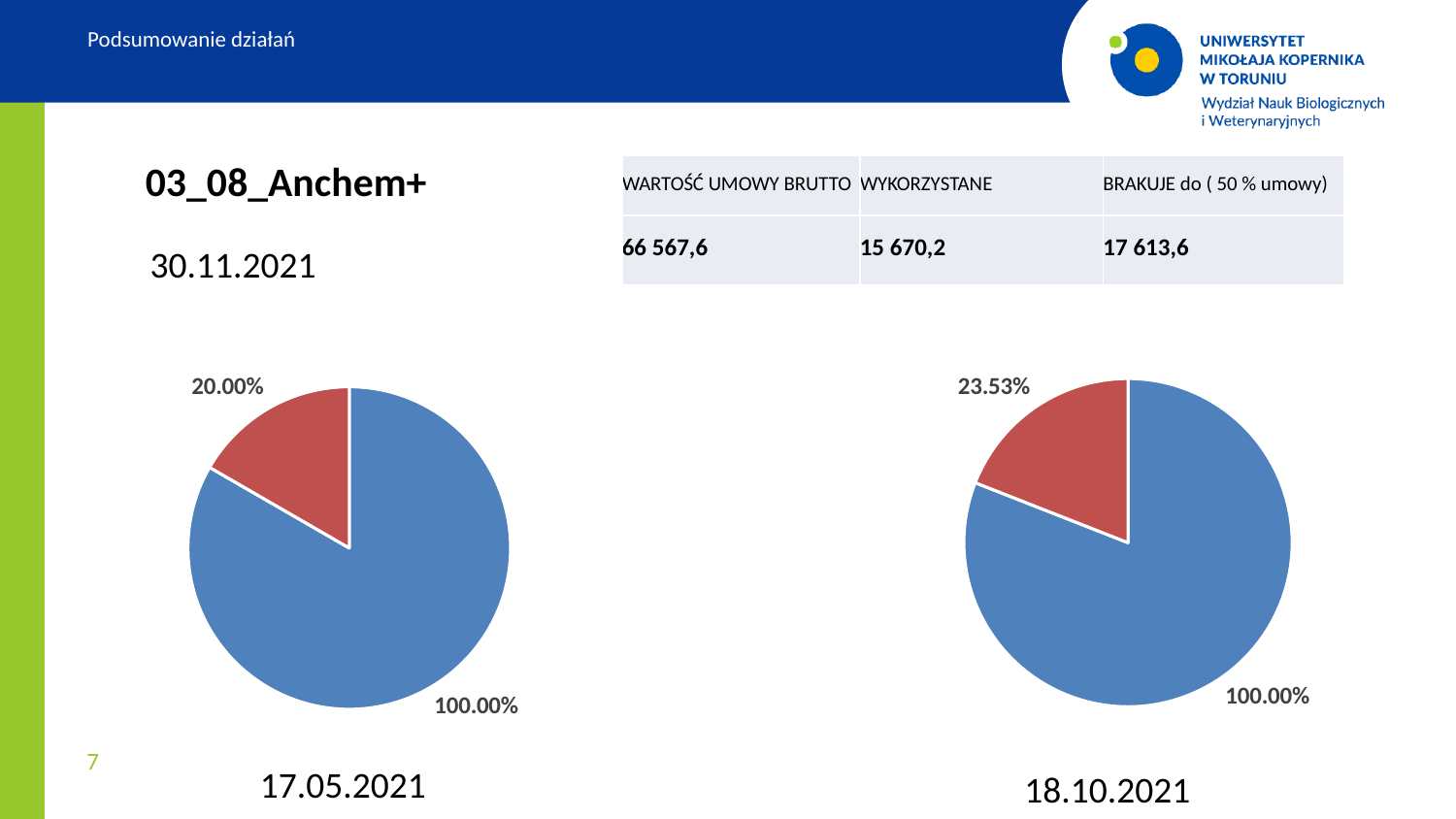
In the right pie chart (18.10.2021), what label is shown on the blue slice? 100.00% In the left pie chart (17.05.2021), which slice is larger, the blue one or the red one? the blue one What two colours are used for the slices in the pie charts on the slide? blue and red What is the difference between the red slice label in the right pie chart (23.53%) and the red slice label in the left pie chart (20.00%)? 3.53 percentage points In the right pie chart (18.10.2021), what percentage label is shown on the red slice? 23.53% How many slices does the left pie chart (17.05.2021) have? 2 How many slices does the right pie chart (18.10.2021) have? 2 What type of chart is shown on the right side of the slide, above the date 18.10.2021? pie chart Which pie chart has the larger red slice, the left one (17.05.2021) or the right one (18.10.2021)? the right one (18.10.2021) What type of chart is shown on the left side of the slide, above the date 17.05.2021? pie chart In the left pie chart (17.05.2021), what percentage label is shown on the red slice? 20.00% In the left pie chart (17.05.2021), what label is shown on the blue slice? 100.00%